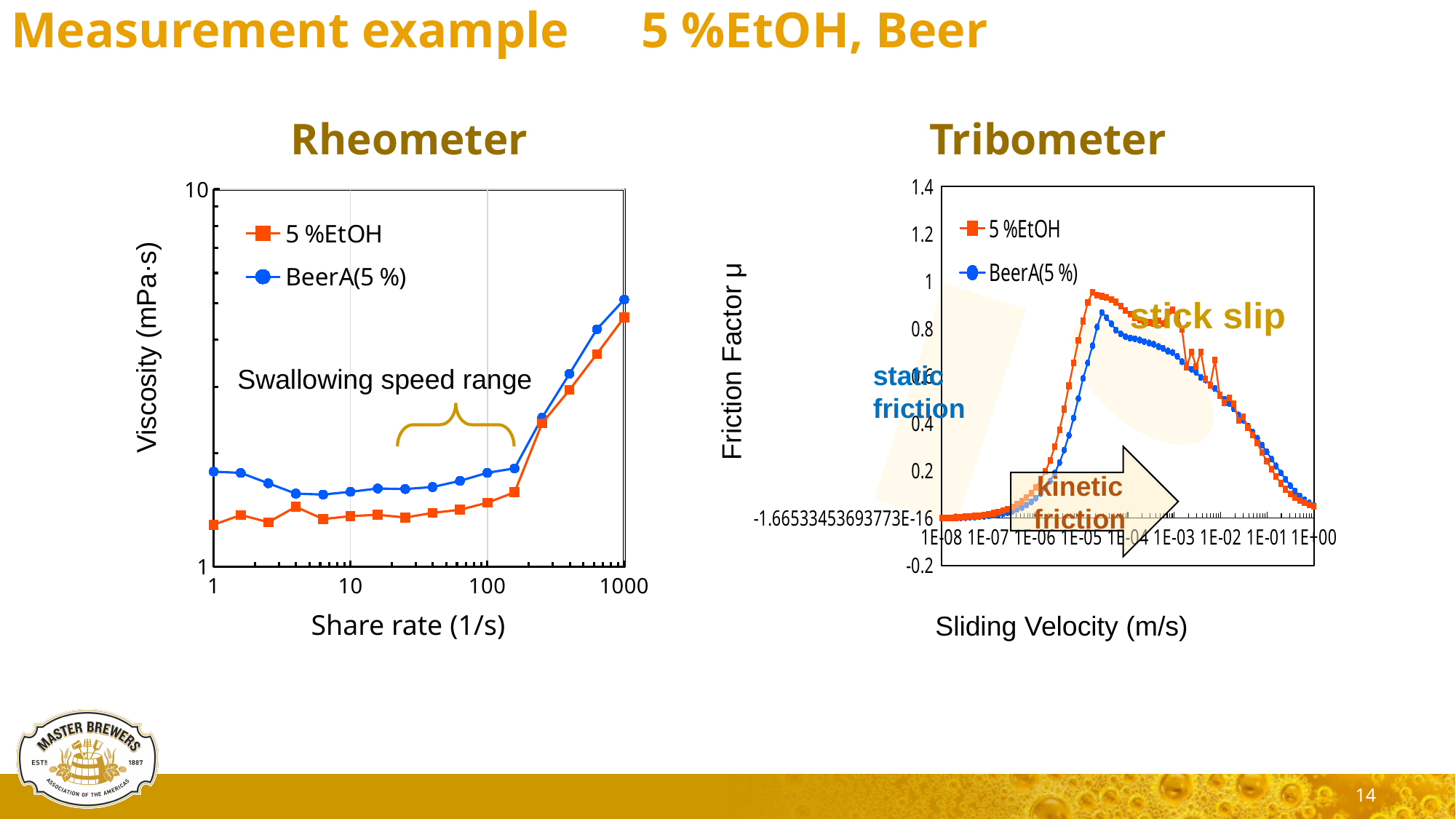
In the Rheometer chart, which series has the higher viscosity at a share rate of 1 (1/s), 5 %EtOH or BeerA(5 %)? BeerA(5 %) How many series does the legend of the Rheometer chart list? 2 In the Tribometer chart, which series reaches the higher peak friction factor, 5 %EtOH or BeerA(5 %)? 5 %EtOH In the Tribometer chart, is the peak friction factor of 5 %EtOH greater or less than 0.8? greater How many series does the legend of the Tribometer chart list? 2 In the Tribometer chart, does the friction factor rise or fall as sliding velocity increases from 1E-03 to 1E+00 m/s? fall What kind of chart is the Rheometer chart? line chart In the Rheometer chart, which series has the higher viscosity at a share rate of 1000 (1/s), 5 %EtOH or BeerA(5 %)? BeerA(5 %) What is the x-axis title of the Tribometer chart? Sliding Velocity (m/s) In the Rheometer chart, does the viscosity of 5 %EtOH rise or fall between share rates of 100 and 1000 (1/s)? rise What kind of chart is the Tribometer chart? line chart In the Rheometer chart, is the viscosity of BeerA(5 %) at a share rate of 1000 (1/s) greater or less than 1 mPa·s? greater